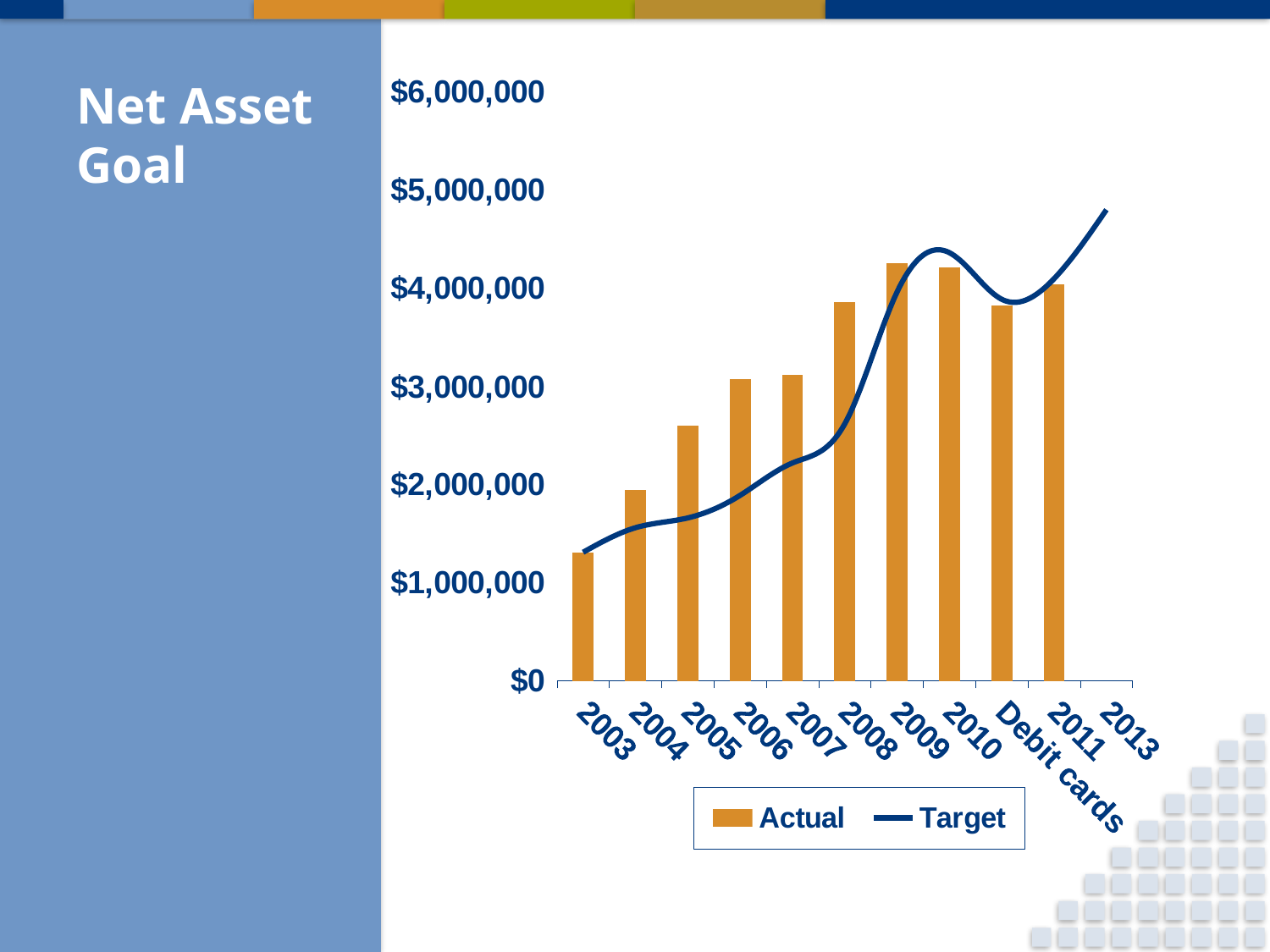
Which category has the lowest Actual bar? 2003 Is the Actual value for 2005 greater or less than $2,000,000? greater How many category labels are shown on the x axis? 11 Is the Actual value for 2009 greater or less than $4,000,000? greater Is the Actual value for 2003 greater or less than $2,000,000? less How many series does the legend list? 2 Which series is drawn as a line rather than bars? Target What are the two series named in the legend? Actual and Target Which has the larger Actual bar, 2005 or 2008? 2008 Do the Actual bars rise or fall from 2003 to 2009? rise Which has the larger Actual bar, 2003 or 2004? 2004